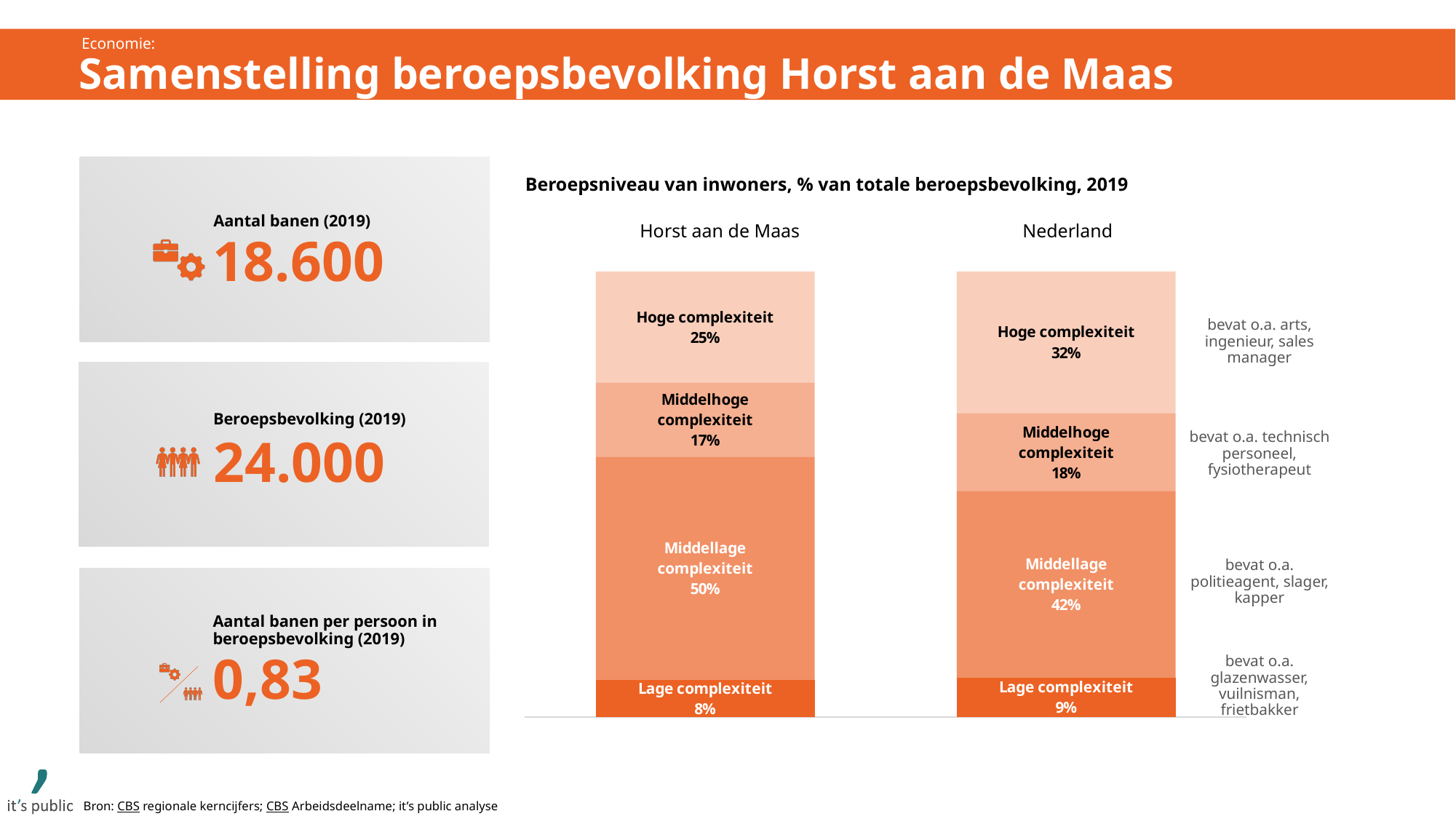
What is the title of the chart? Beroepsniveau van inwoners, % van totale beroepsbevolking, 2019 Which has a larger share of 'Middellage complexiteit': Horst aan de Maas or Nederland? Horst aan de Maas How many bars are shown in the chart? 2 How many complexity levels (segments) does each bar contain? 4 What is the value for 'Hoge complexiteit' in the Nederland bar? 32% What is the value for 'Lage complexiteit' in the Horst aan de Maas bar? 8% What percentage of the Horst aan de Maas workforce is in 'Middellage complexiteit'? 50% Which segment is the smallest in the Nederland bar? Lage complexiteit Which segment is the largest in the Horst aan de Maas bar? Middellage complexiteit What type of chart is shown on the slide? Stacked bar chart What is the value for 'Middelhoge complexiteit' in the Horst aan de Maas bar? 17% How many percentage points higher is 'Hoge complexiteit' for Nederland than for Horst aan de Maas? 7 percentage points